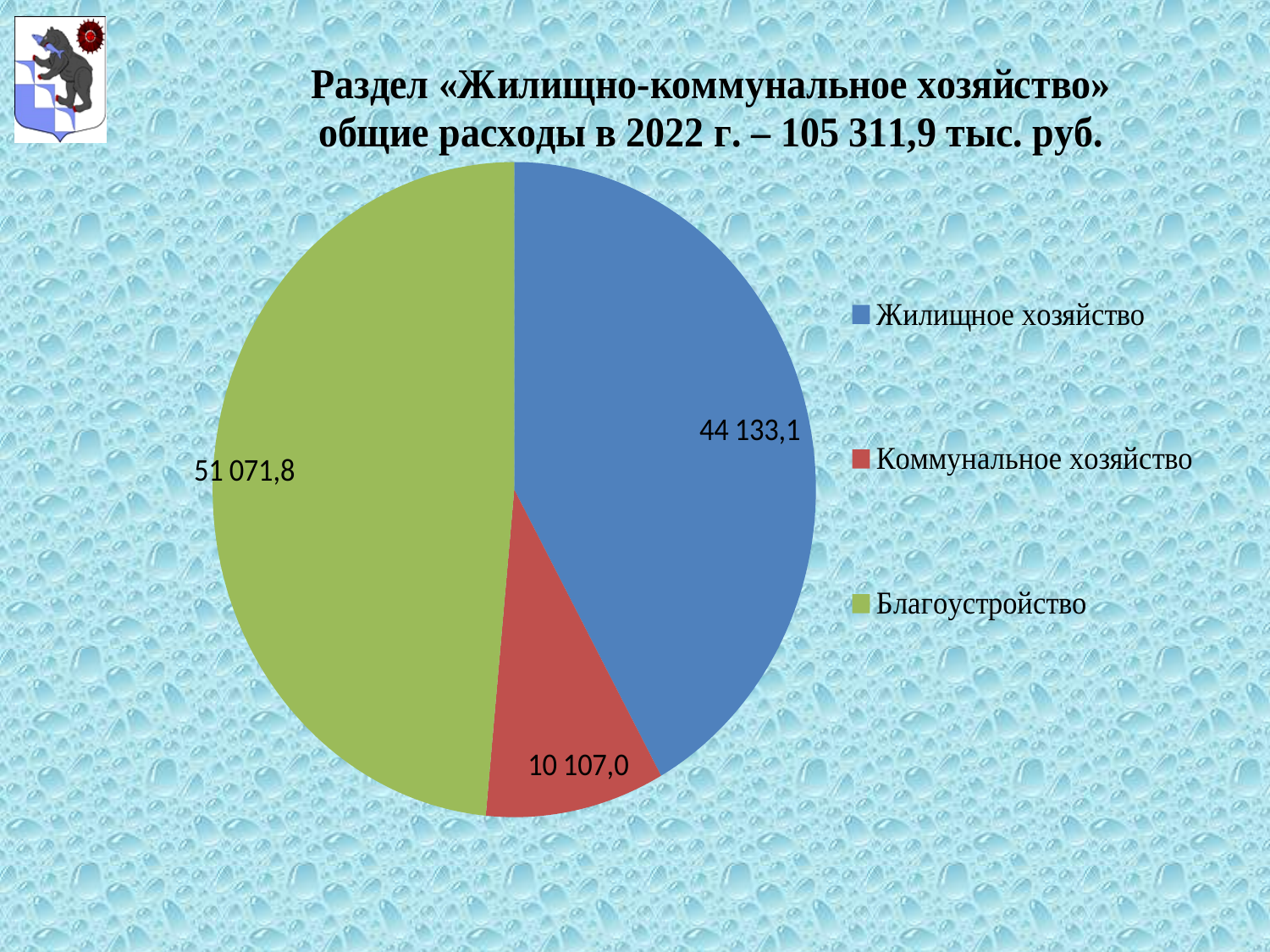
What is the total of all three slices, as stated in the slide title? 105 311,9 тыс. руб. What colour is the slice for Коммунальное хозяйство? Red Which category has the largest slice of the pie? Благоустройство Which category has the smallest slice of the pie? Коммунальное хозяйство What is the value for Коммунальное хозяйство? 10 107,0 What is the difference between the values for Благоустройство and Жилищное хозяйство? 6 938,7 How many slices does the pie chart have? 3 What is the difference between the values for Жилищное хозяйство and Коммунальное хозяйство? 34 026,1 What is the value for Жилищное хозяйство? 44 133,1 What type of chart is shown on the slide? Pie chart Which is larger, the value for Жилищное хозяйство or the value for Коммунальное хозяйство? Жилищное хозяйство What is the value for Благоустройство? 51 071,8